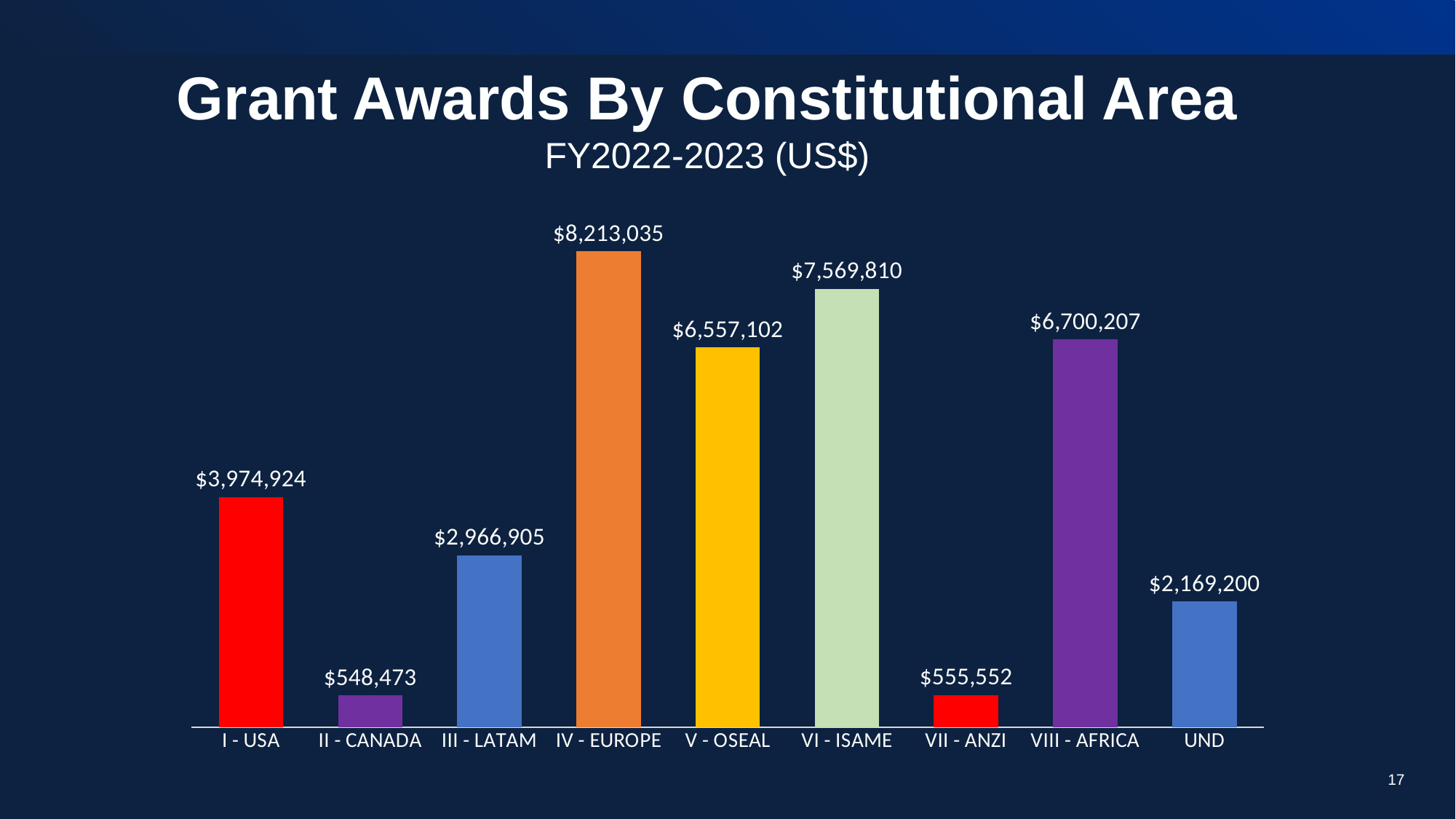
What is the grant award value for II - CANADA? $548,473 What kind of chart is shown on the slide? Bar chart What is the difference between the grant awards for IV - EUROPE and VI - ISAME? $643,225 What is the grant award value for VI - ISAME? $7,569,810 How many constitutional areas are shown on the chart? 9 What is the grant award value for IV - EUROPE? $8,213,035 Which constitutional area has the lowest grant award value? II - CANADA What is the grant award value for UND? $2,169,200 Which has a larger grant award value, I - USA or UND? I - USA Which constitutional area has the highest grant award value? IV - EUROPE Which has a larger grant award value, VIII - AFRICA or V - OSEAL? VIII - AFRICA What is the difference between the grant awards for I - USA and III - LATAM? $1,008,019